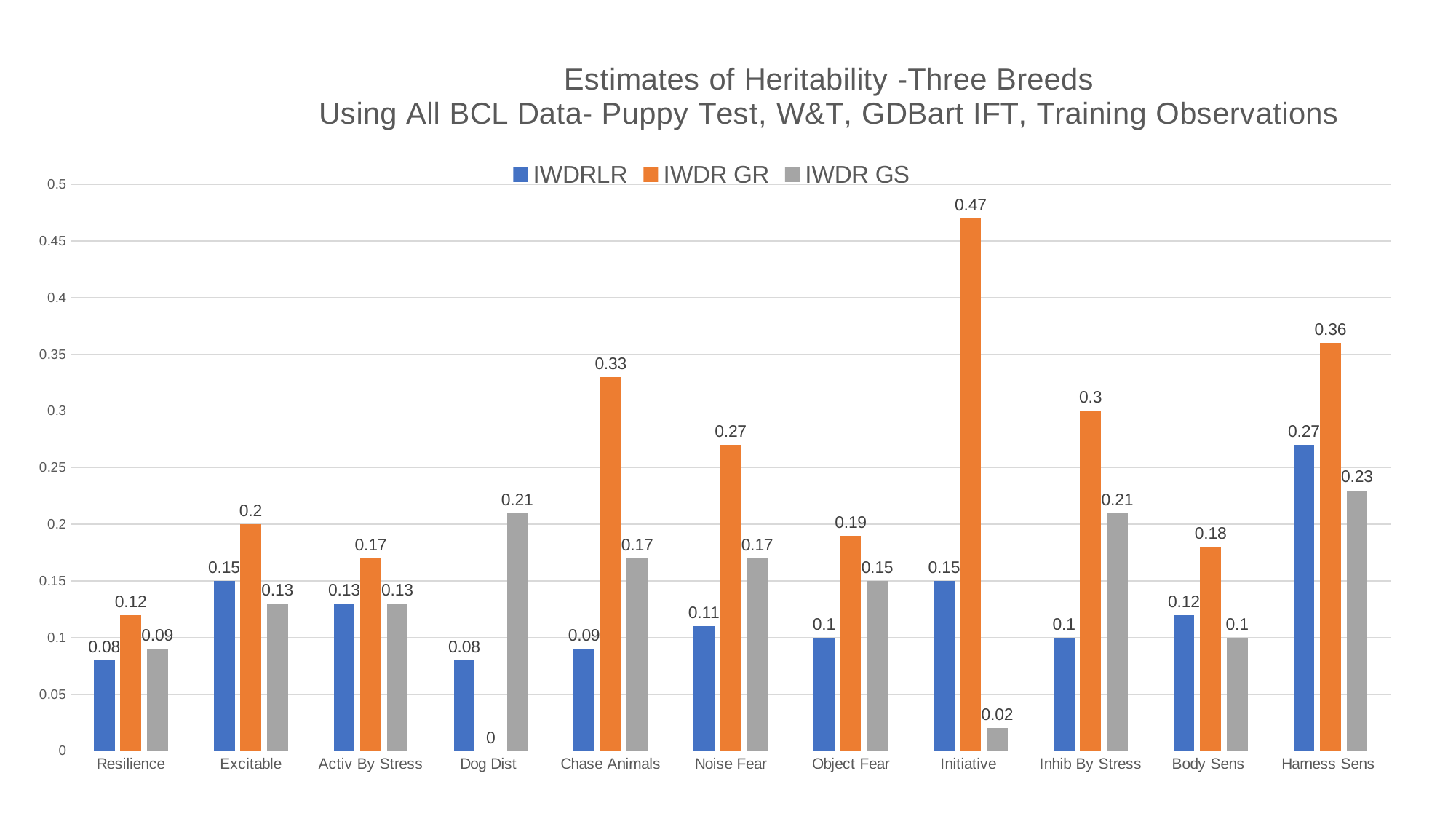
What is the difference between the IWDR GR and IWDRLR values for Chase Animals? 0.24 Which is larger for Inhib By Stress: the IWDR GR value or the IWDR GS value? IWDR GR Which category has the lowest IWDR GS value? Initiative What is the IWDRLR value for Harness Sens? 0.27 How many series does the legend list? 3 What kind of chart is shown on the slide? Bar chart What is the IWDR GS value for Dog Dist? 0.21 Which series is shown in orange? IWDR GR Which category has the highest IWDR GR value? Initiative How many categories are shown on the x axis? 11 Is the IWDR GR value for Harness Sens greater or less than 0.4? less What is the IWDR GR value for Initiative? 0.47